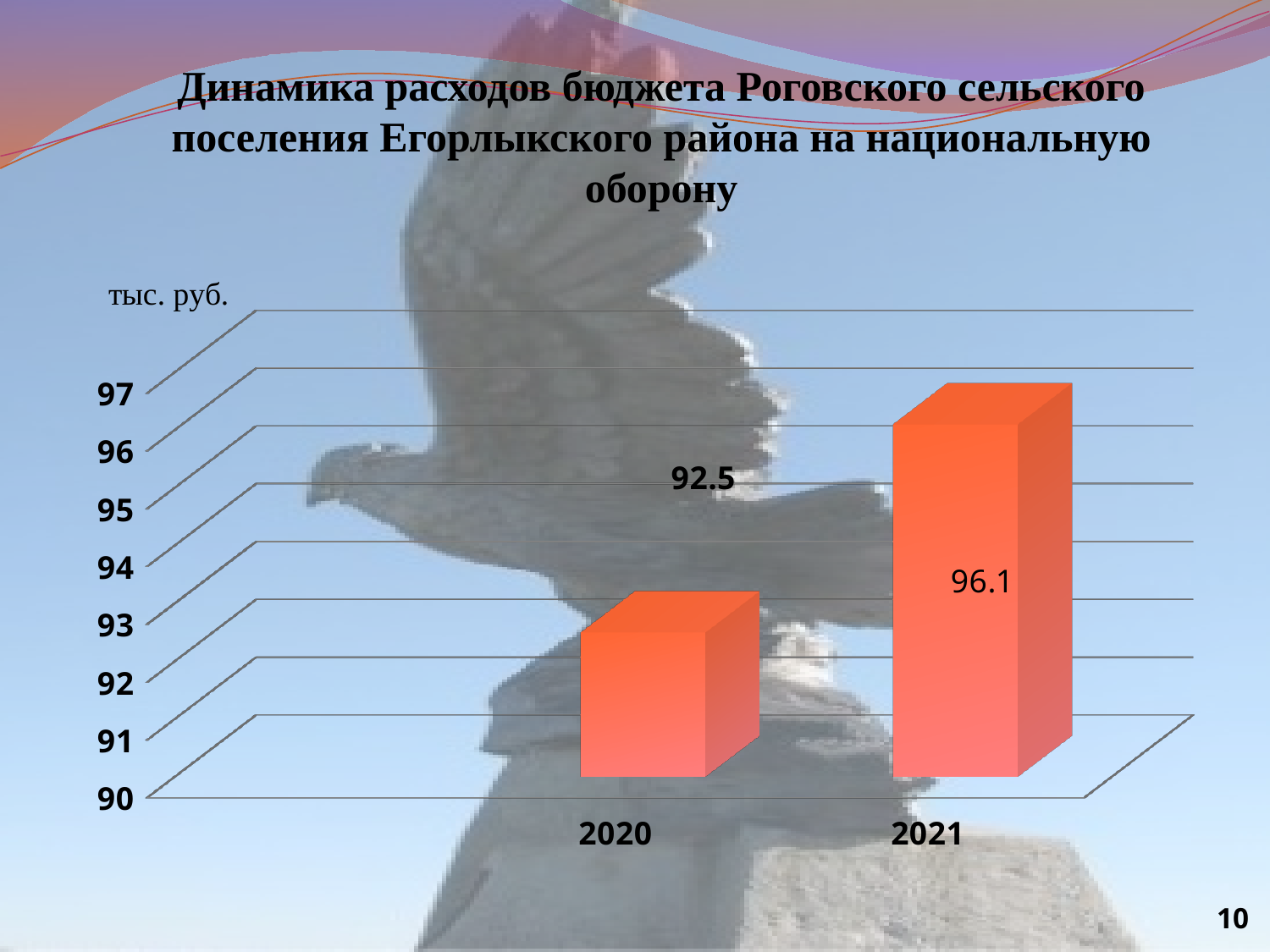
How many years are shown on the chart? 2 What is the value for 2020? 92.5 Is the value for 2020 greater or less than 94? less What unit is shown above the vertical axis of the chart? тыс. руб. What kind of chart is shown on the slide? bar chart Which is larger, the value for 2020 or the value for 2021? 2021 Do the values rise or fall from 2020 to 2021? rise What is the difference between the values for 2021 and 2020? 3.6 What is the value for 2021? 96.1 Which year has the highest value? 2021 Is the value for 2021 greater or less than 95? greater Which year has the lowest value? 2020